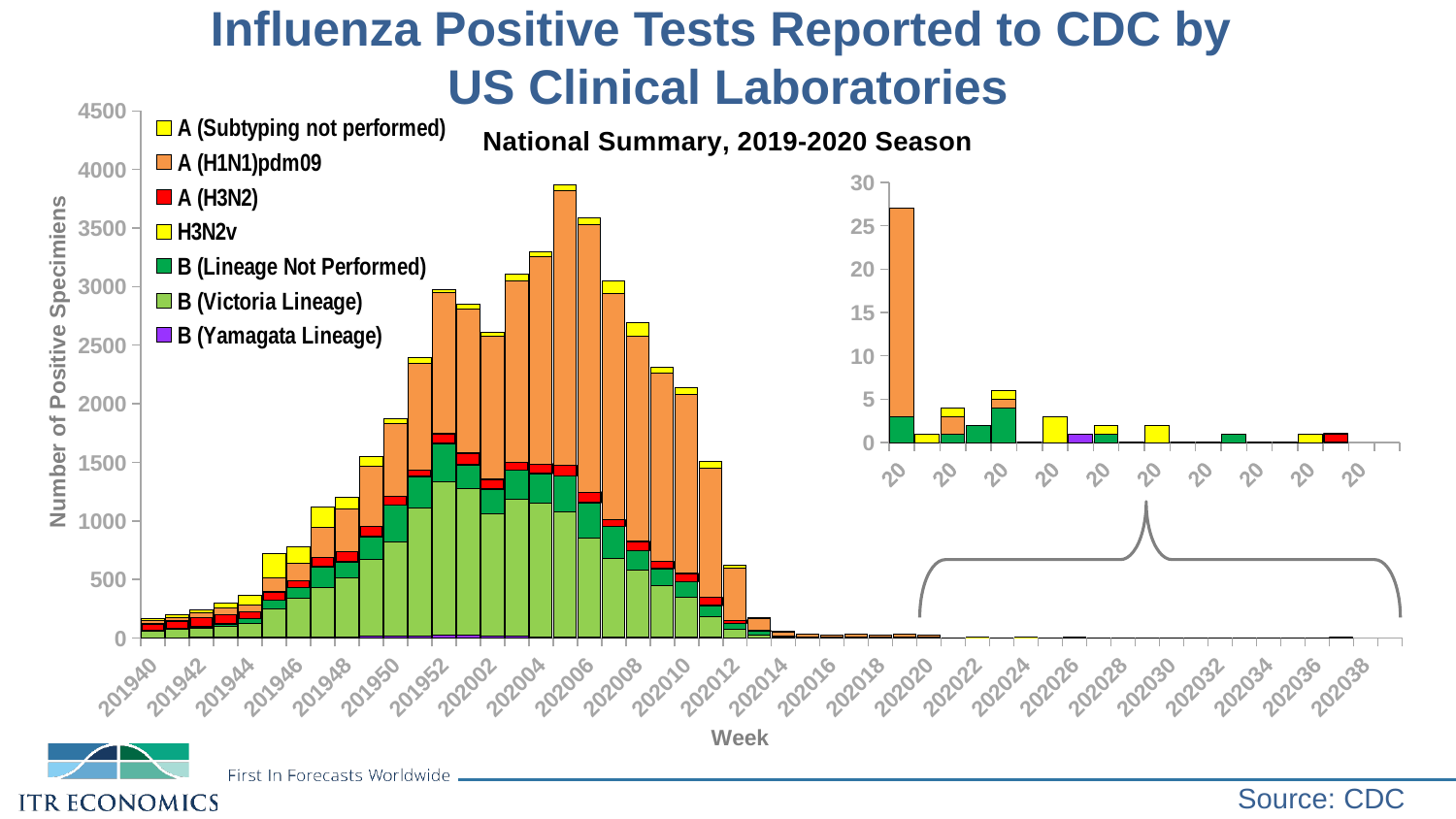
In the main chart, is the total value for week 202014 greater or less than 500? less In the inset chart, is the tallest bar greater or less than 25? greater In the main chart, is the total value for week 201940 greater or less than 500? less In the main chart, which week has the larger total: 202006 or 202010? 202006 What colour represents A (H1N1)pdm09 in the legend? Orange What kind of chart is the main chart on the slide? Stacked bar chart How many series does the legend of the main chart list? 7 In the main chart, which week has the larger total: 201944 or 201948? 201948 In the main chart, do the totals rise or fall from week 202006 to week 202020? fall